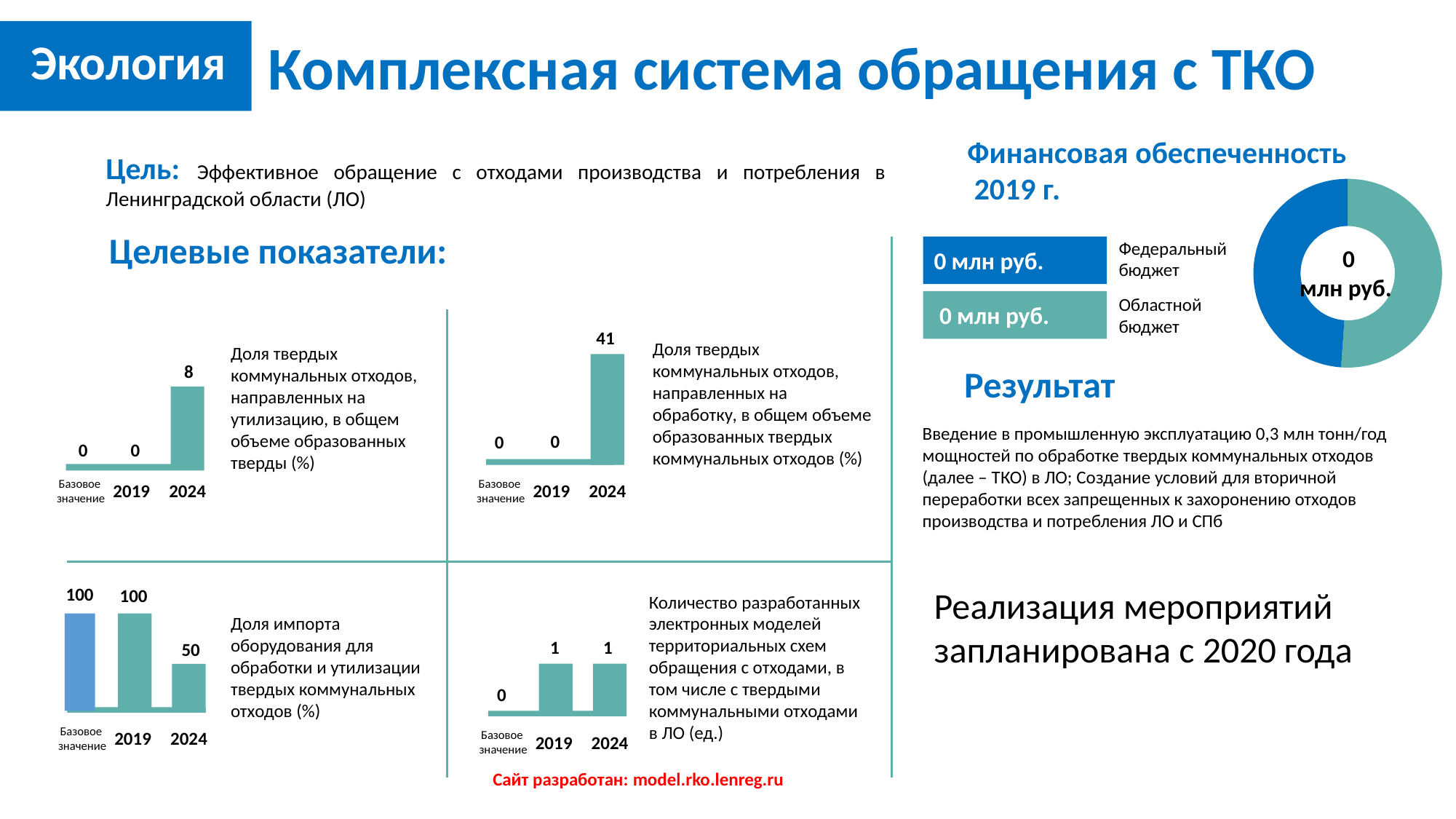
In the top-left bar chart (share of solid municipal waste sent for utilization), what is the value for 2024? 8 In the bottom-left bar chart (share of imported equipment), what is the difference between the 2019 value and the 2024 value? 50 In the top-left bar chart (share of waste sent for utilization), how many categories are shown on the x axis? 3 In the bottom-left bar chart (share of imported equipment), which category has the lowest value? 2024 In the bottom-left bar chart (share of imported equipment for processing and utilization of solid municipal waste), what is the value for 2024? 50 In the top-right bar chart (share of waste sent for processing), which category has the highest value? 2024 In the 'Финансовая обеспеченность 2019 г.' chart, what value is shown for the Федеральный бюджет? 0 млн руб. What kind of chart is used for 'Финансовая обеспеченность 2019 г.'? Donut (pie) chart In the bottom-right bar chart (number of developed electronic models of territorial waste management schemes), what is the value for 2019? 1 In the top-right bar chart (share of solid municipal waste sent for processing), what is the value for 2024? 41 In the bottom-right bar chart (number of developed electronic models), what is the base value (Базовое значение)? 0 In the bottom-left bar chart (share of imported equipment), what is the value for 2019? 100